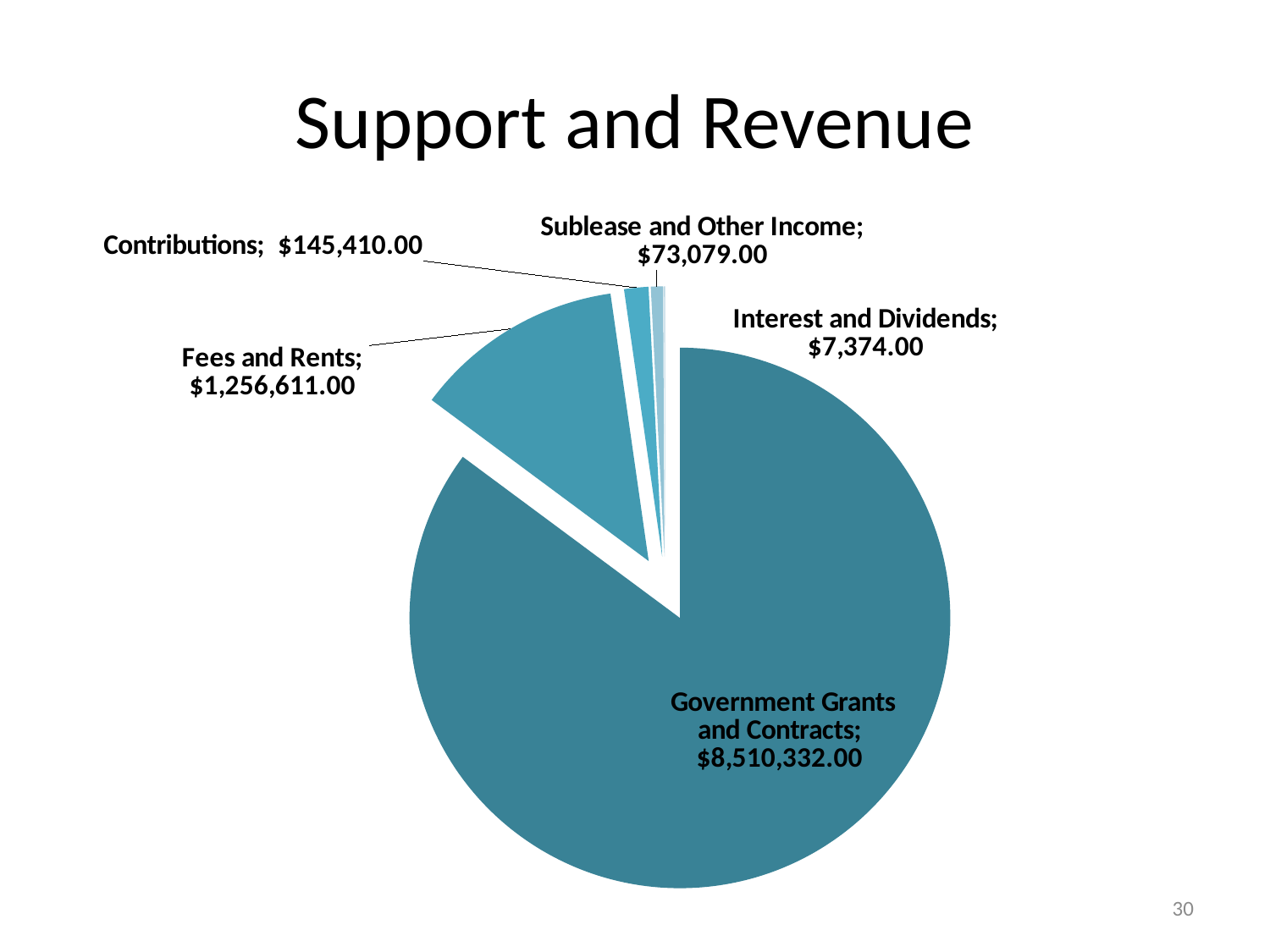
Which category has the largest slice of the pie? Government Grants and Contracts What is the value for Contributions? $145,410.00 What is the value for Fees and Rents? $1,256,611.00 How many slices does the pie chart have? 5 Which category has the smallest value? Interest and Dividends What is the value for Interest and Dividends? $7,374.00 What is the value for Sublease and Other Income? $73,079.00 What type of chart is shown on the slide? Pie chart What is the title of the chart? Support and Revenue What is the value for Government Grants and Contracts? $8,510,332.00 Which is larger, Contributions or Sublease and Other Income? Contributions What is the difference between Fees and Rents and Contributions? $1,111,201.00